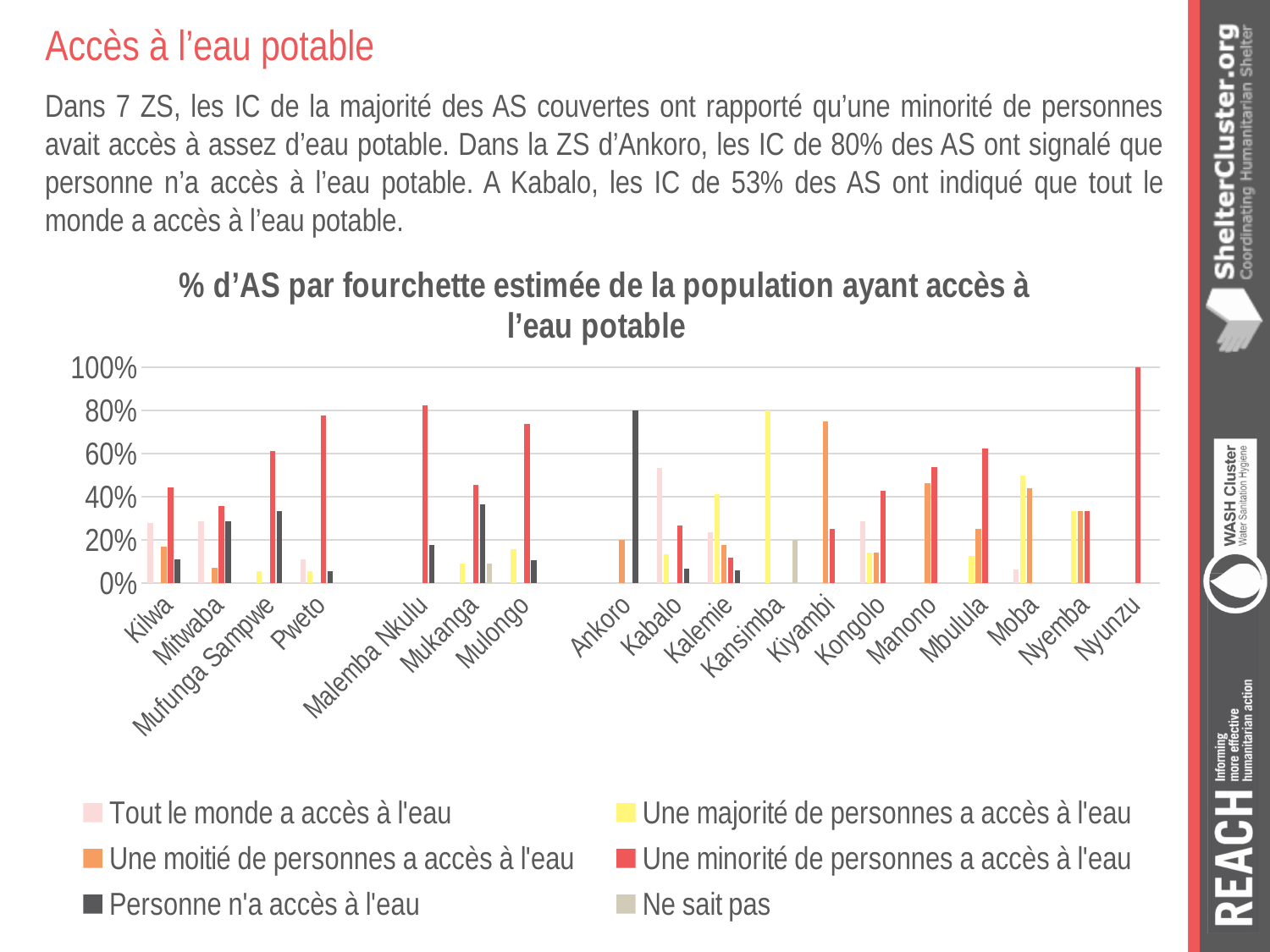
How many zones de santé (categories) are shown on the x axis? 18 Which zone has the highest value for 'Une minorité de personnes a accès à l'eau'? Nyunzu Is the value of 'Une minorité de personnes a accès à l'eau' for Mulongo greater or less than 60%? greater Is the value of 'Tout le monde a accès à l'eau' for Kabalo greater or less than 40%? greater Which zone has the highest value for 'Personne n'a accès à l'eau'? Ankoro How many series does the legend list? 6 Which is larger: 'Une moitié de personnes a accès à l'eau' for Kiyambi or for Kilwa? Kiyambi What is the value of 'Une minorité de personnes a accès à l'eau' for Nyunzu? 100% What kind of chart is shown on the slide? bar chart What is the title of the chart? % d'AS par fourchette estimée de la population ayant accès à l'eau potable What is the value of 'Personne n'a accès à l'eau' for Ankoro? 80% Is the value of 'Une moitié de personnes a accès à l'eau' for Kiyambi greater or less than 60%? greater